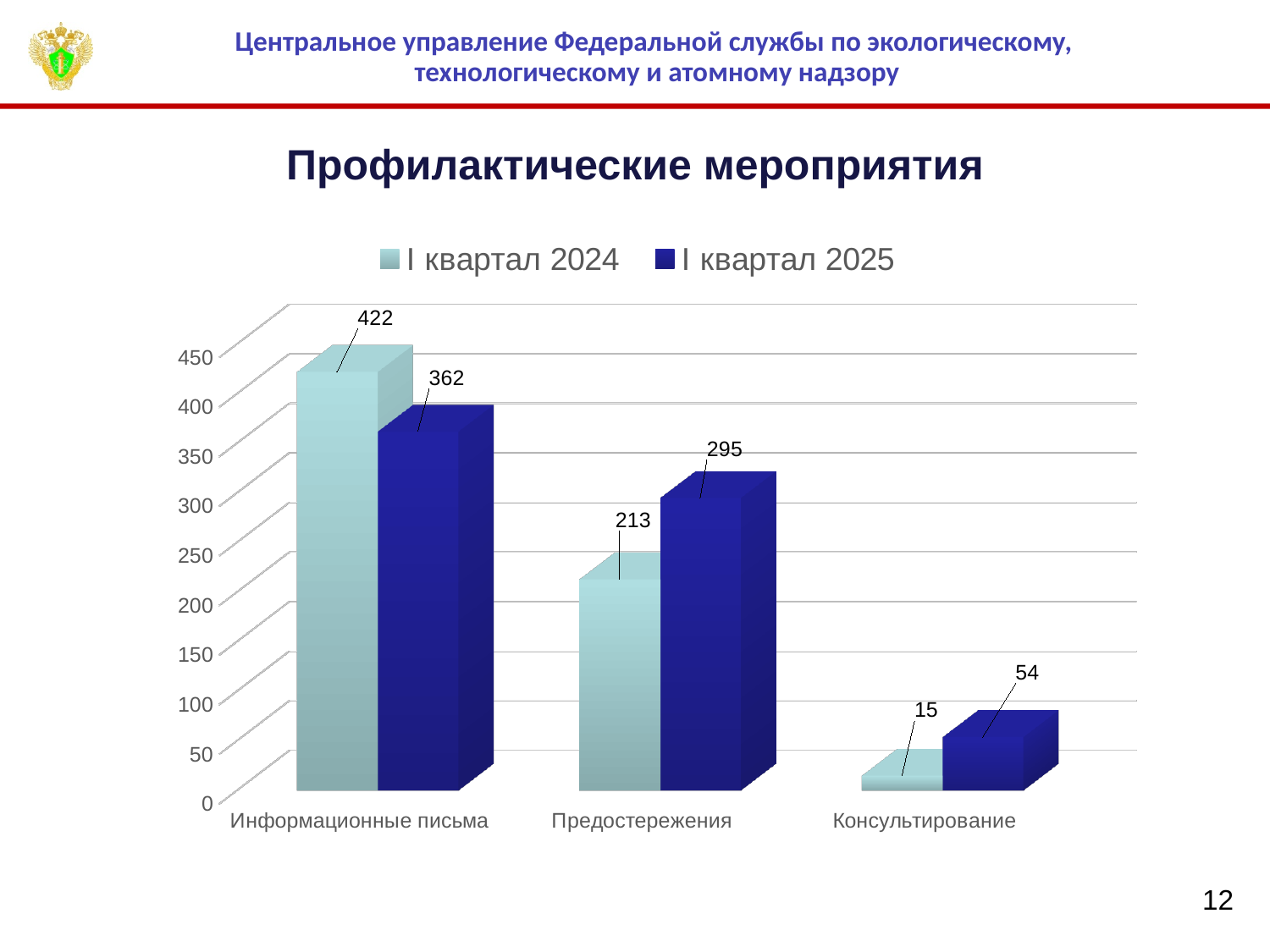
What kind of chart is shown on the slide? Bar chart What is the difference between the I квартал 2024 and I квартал 2025 values for Информационные письма? 60 What is the value for Информационные письма in I квартал 2024? 422 Which category has the highest value in I квартал 2025? Информационные письма What is the value for Предостережения in I квартал 2025? 295 How many categories are shown on the x axis? 3 Which is larger for Консультирование: I квартал 2024 or I квартал 2025? I квартал 2025 What is the title of the chart? Профилактические мероприятия What is the value for Консультирование in I квартал 2024? 15 What is the difference between the I квартал 2025 and I квартал 2024 values for Предостережения? 82 Which category has the lowest value in I квартал 2024? Консультирование How many series does the legend list? 2